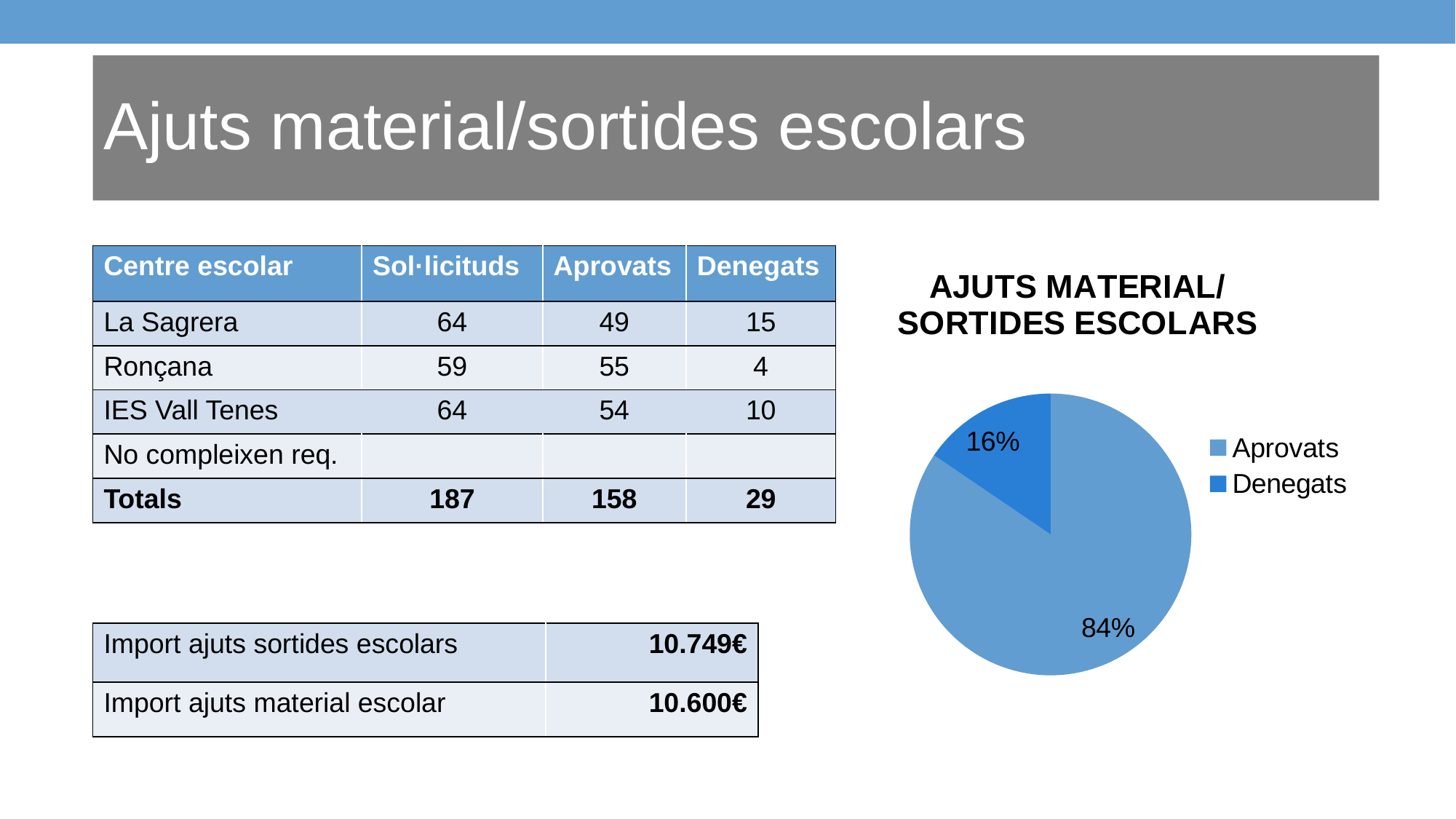
What is the difference in percentage points between the Aprovats and Denegats slices? 68 How many entries does the pie chart legend list? 2 What is the title of the pie chart? AJUTS MATERIAL/ SORTIDES ESCOLARS What share of the pie chart is Aprovats? 84% Which legend entry is shown in the darker blue colour in the pie chart? Denegats Is the Aprovats share of the pie chart greater or less than 50%? greater Which is larger in the pie chart, Aprovats or Denegats? Aprovats What kind of chart is shown on the slide? pie chart What share of the pie chart is Denegats? 16% Which slice of the pie chart is the largest? Aprovats Which slice of the pie chart is the smallest? Denegats How many slices does the pie chart have? 2